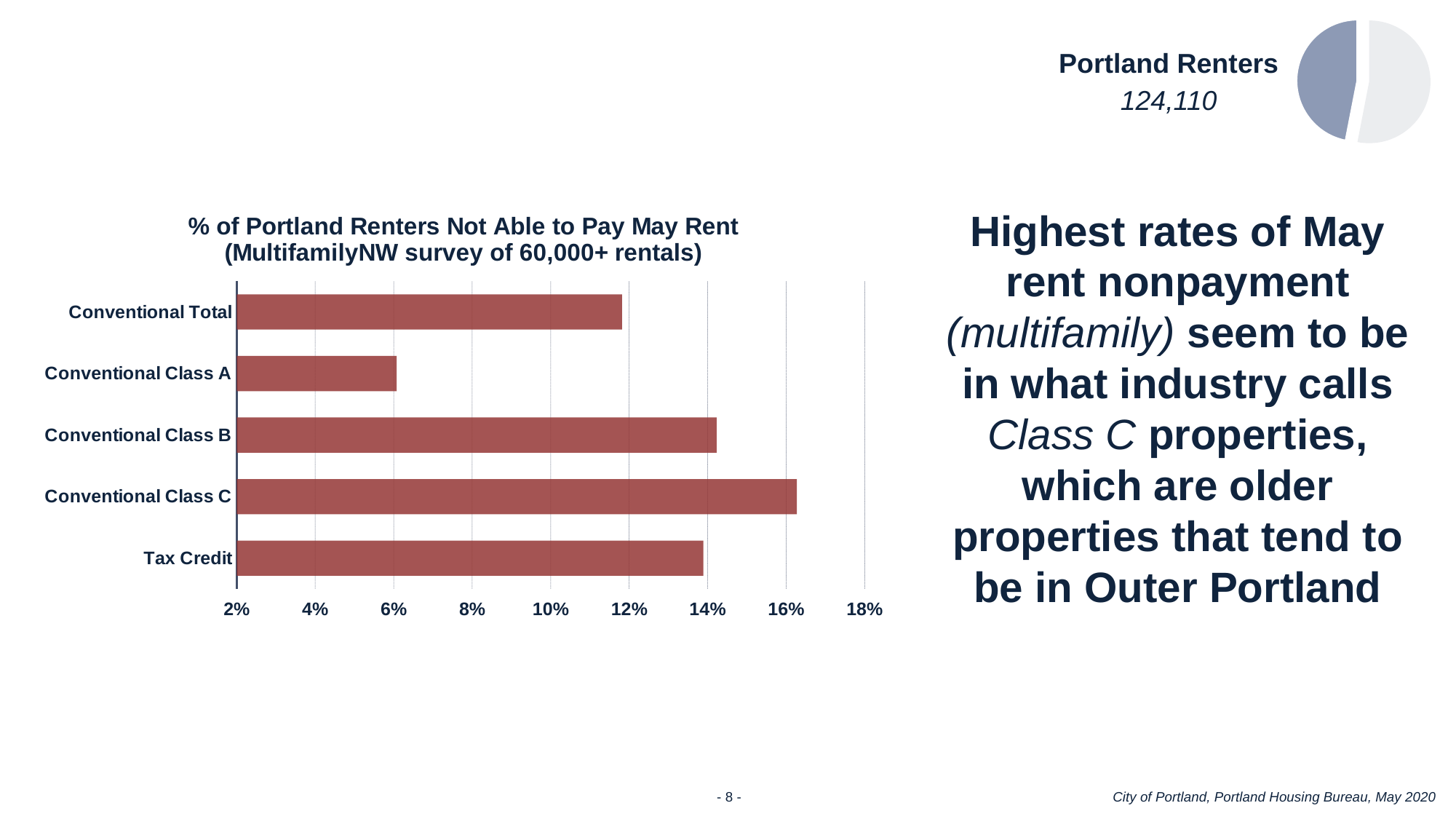
How many categories are plotted in the bar chart? 5 Is the value for Conventional Total greater or less than 10%? greater Which category has the highest percentage of renters not able to pay May rent? Conventional Class C Is the value for Conventional Class A greater or less than 8%? less Is the value for Tax Credit greater or less than 12%? greater Which is larger, the value for Conventional Class A or Conventional Total? Conventional Total Which category has the lowest percentage of renters not able to pay May rent? Conventional Class A Which is larger, the value for Conventional Class C or Conventional Class B? Conventional Class C What kind of chart is shown on the slide? a bar chart and a pie chart What is the highest tick label shown on the chart's horizontal axis? 18%